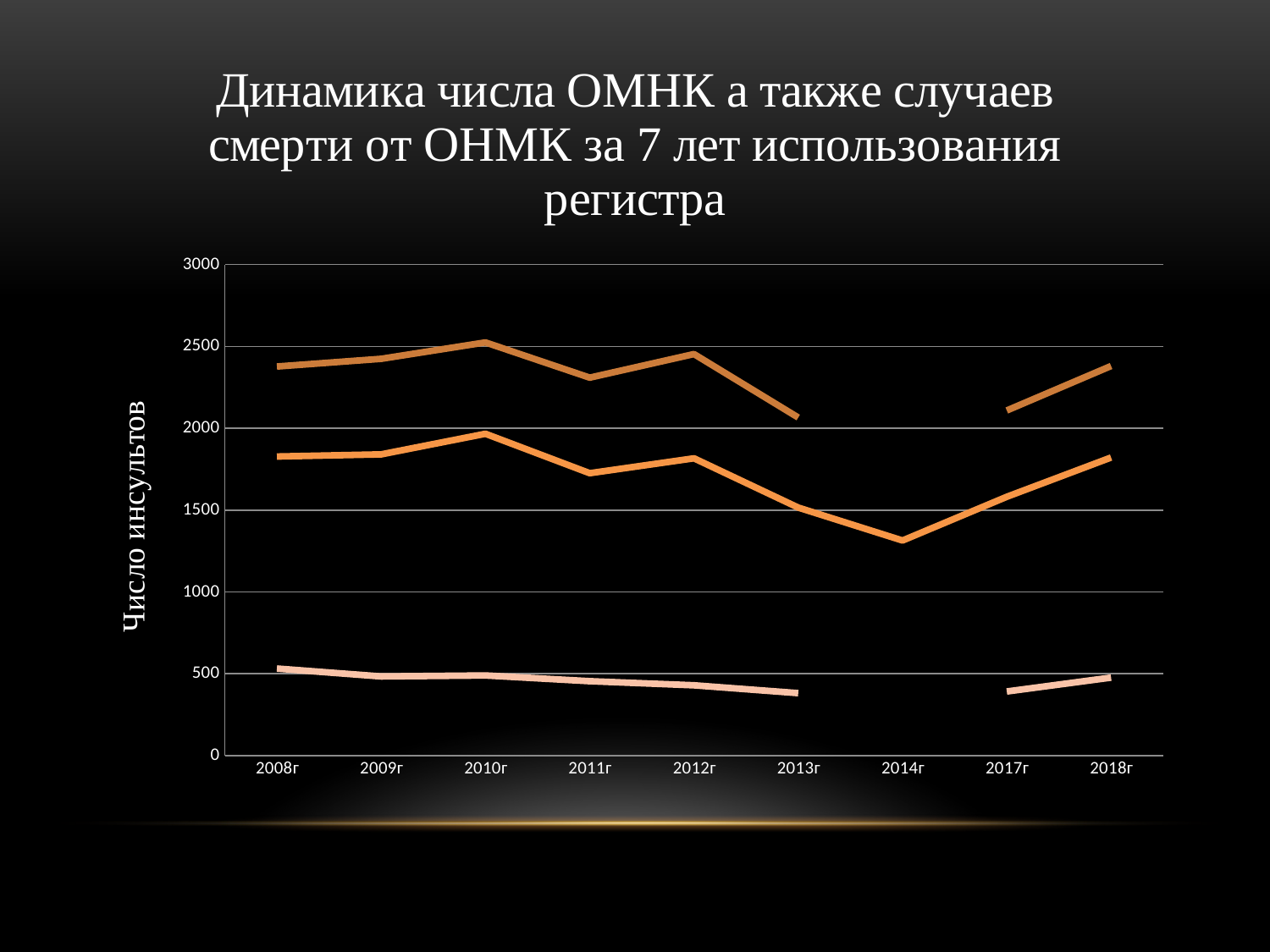
What is the title of the vertical axis? Число инсультов What is the highest tick value shown on the vertical axis? 3000 How many lines are plotted on the chart? 3 Is the value of the bottom line for 2013г greater or less than 500? less In which year does the middle line reach its lowest value? 2014г How many year categories are shown on the x axis? 9 Is the value of the middle line for 2010г greater or less than 1500? greater Is the value of the middle line for 2014г greater or less than 1500? less What kind of chart is shown on the slide? line chart In which year does the middle line reach its highest value? 2010г Does the middle line rise or fall from 2012г to 2014г? fall